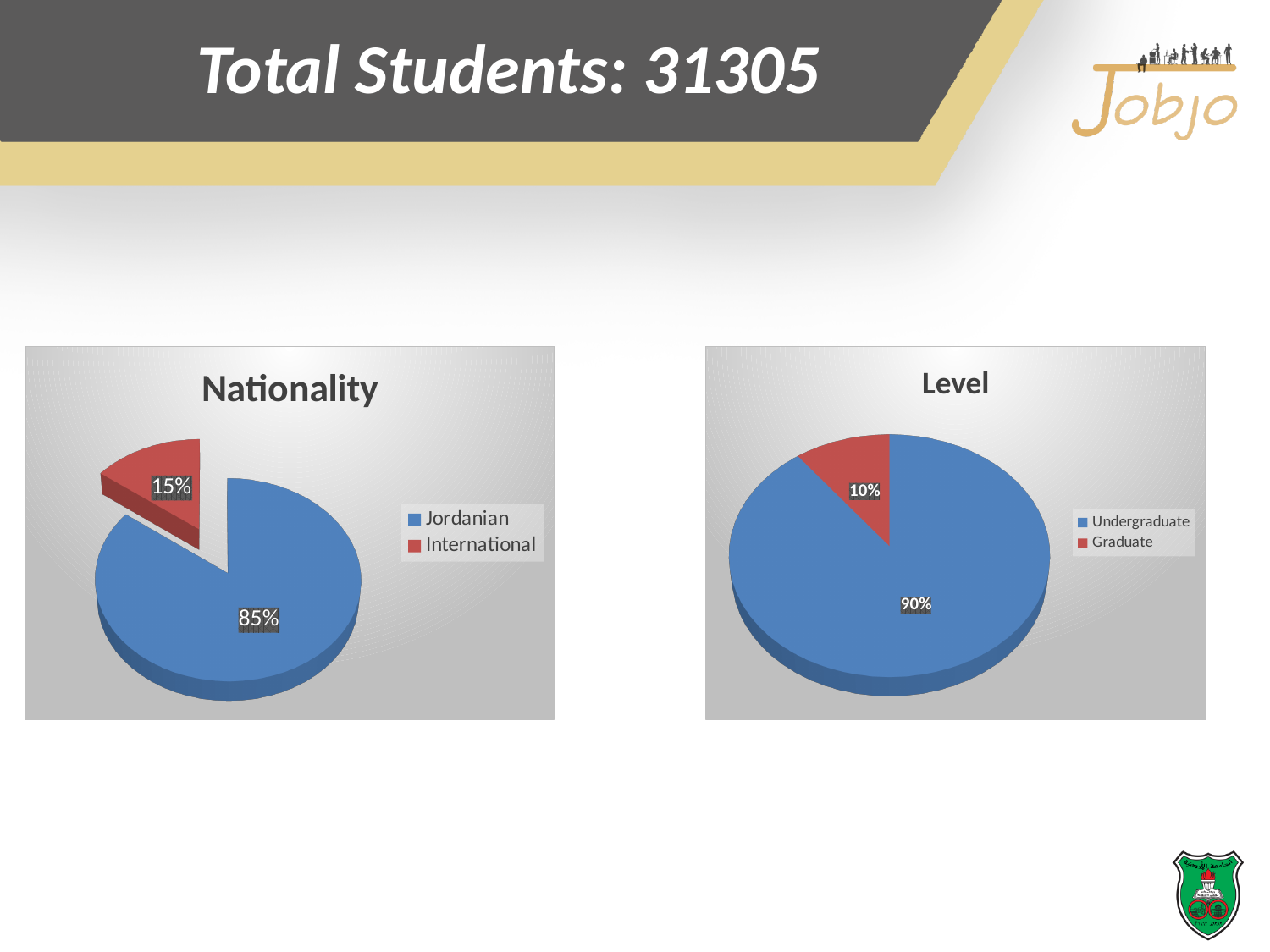
How many slices does the Nationality chart have? 2 In the Level chart, what share of students are Graduate? 10% In the Nationality chart, what share of students are Jordanian? 85% In the Nationality chart, what share of students are International? 15% In the Level chart, which category has the smallest slice? Graduate What kind of chart is the Level chart? Pie chart In the Level chart, what is the difference in percentage points between the Undergraduate and Graduate slices? 80 In the Nationality chart, which category has the largest slice? Jordanian In the Nationality chart, what is the difference in percentage points between the Jordanian and International slices? 70 In the Nationality chart, which colour represents the International slice? Red How many entries does the legend of the Level chart list? 2